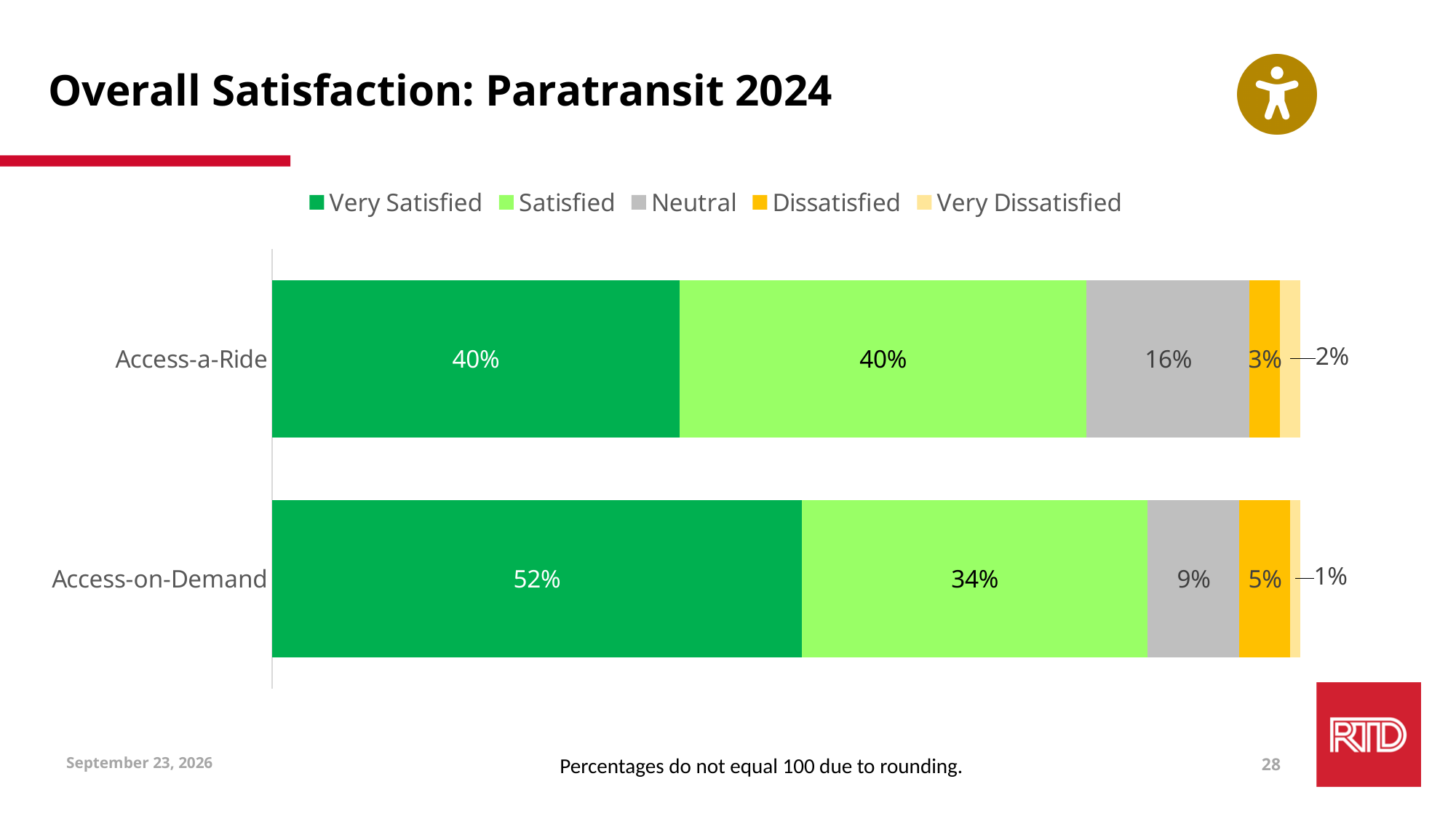
How many services (categories) are shown in the chart? 2 What percentage of Access-on-Demand respondents were Very Satisfied? 52% Is the Satisfied percentage larger for Access-a-Ride or Access-on-Demand? Access-a-Ride How many series does the legend list? 5 What is the Neutral percentage for Access-a-Ride? 16% What percentage of Access-a-Ride respondents were Very Satisfied? 40% What type of chart is shown on the slide? Stacked bar chart Which service has the higher Very Satisfied percentage? Access-on-Demand What is the difference between the Very Satisfied percentages for Access-on-Demand and Access-a-Ride? 12% What is the Dissatisfied percentage for Access-on-Demand? 5% Which service has the lower Neutral percentage? Access-on-Demand What is the Very Dissatisfied percentage for Access-a-Ride? 2%